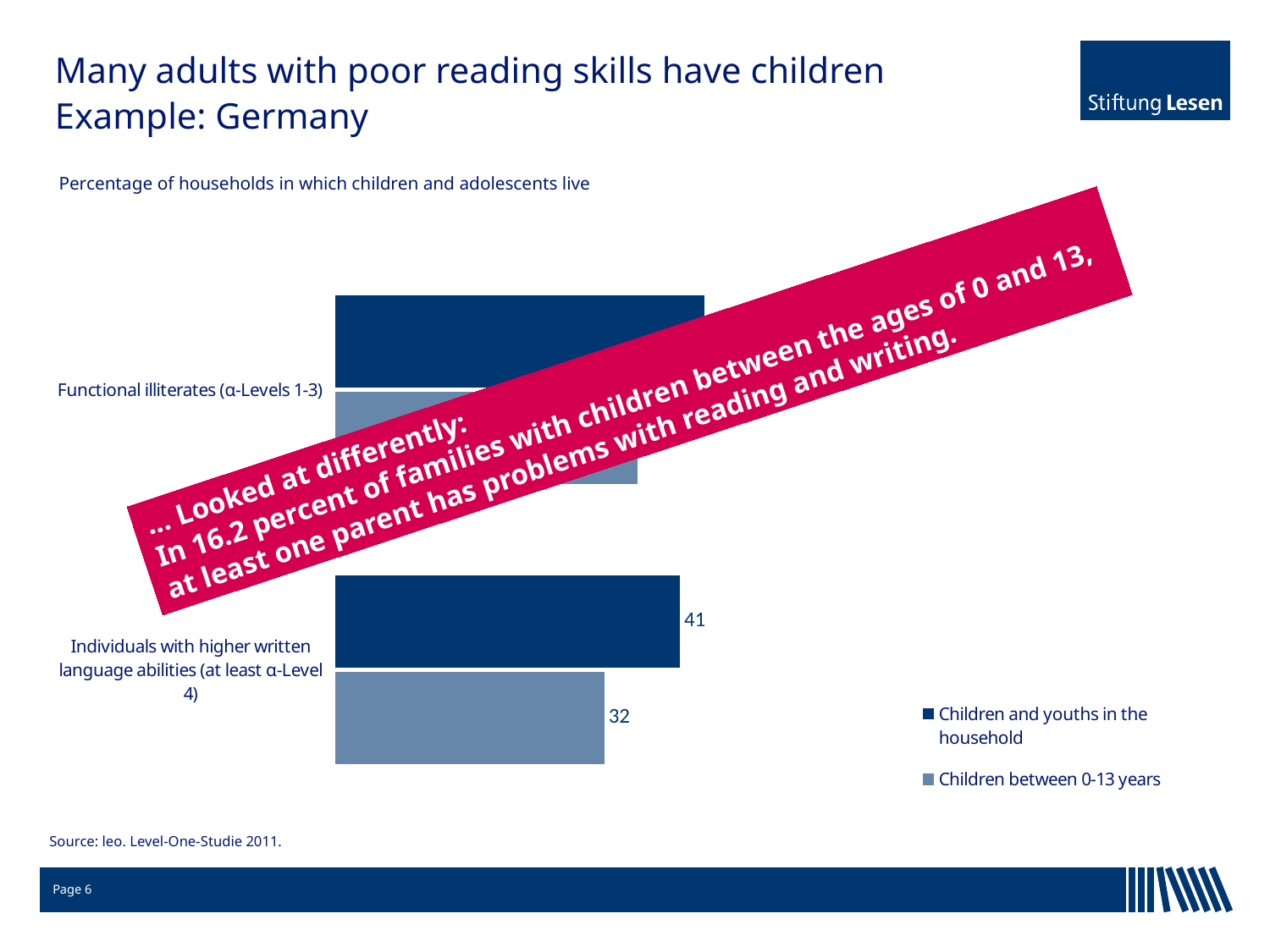
What is the value for 'Children and youths in the household' for individuals with higher written language abilities (at least α-Level 4)? 41 For individuals with higher written language abilities, which series has the larger value: 'Children and youths in the household' or 'Children between 0-13 years'? Children and youths in the household How many series does the legend list? 2 What is the chart's subtitle describing what the values represent? Percentage of households in which children and adolescents live How many categories are shown on the chart? 2 For individuals with higher written language abilities, what is the difference between the 'Children and youths in the household' value and the 'Children between 0-13 years' value? 9 For functional illiterates (α-Levels 1-3), which series has the longer bar: 'Children and youths in the household' or 'Children between 0-13 years'? Children and youths in the household What are the two series named in the legend? Children and youths in the household; Children between 0-13 years What is the value for 'Children between 0-13 years' for individuals with higher written language abilities (at least α-Level 4)? 32 What kind of chart is shown on the slide? Bar chart